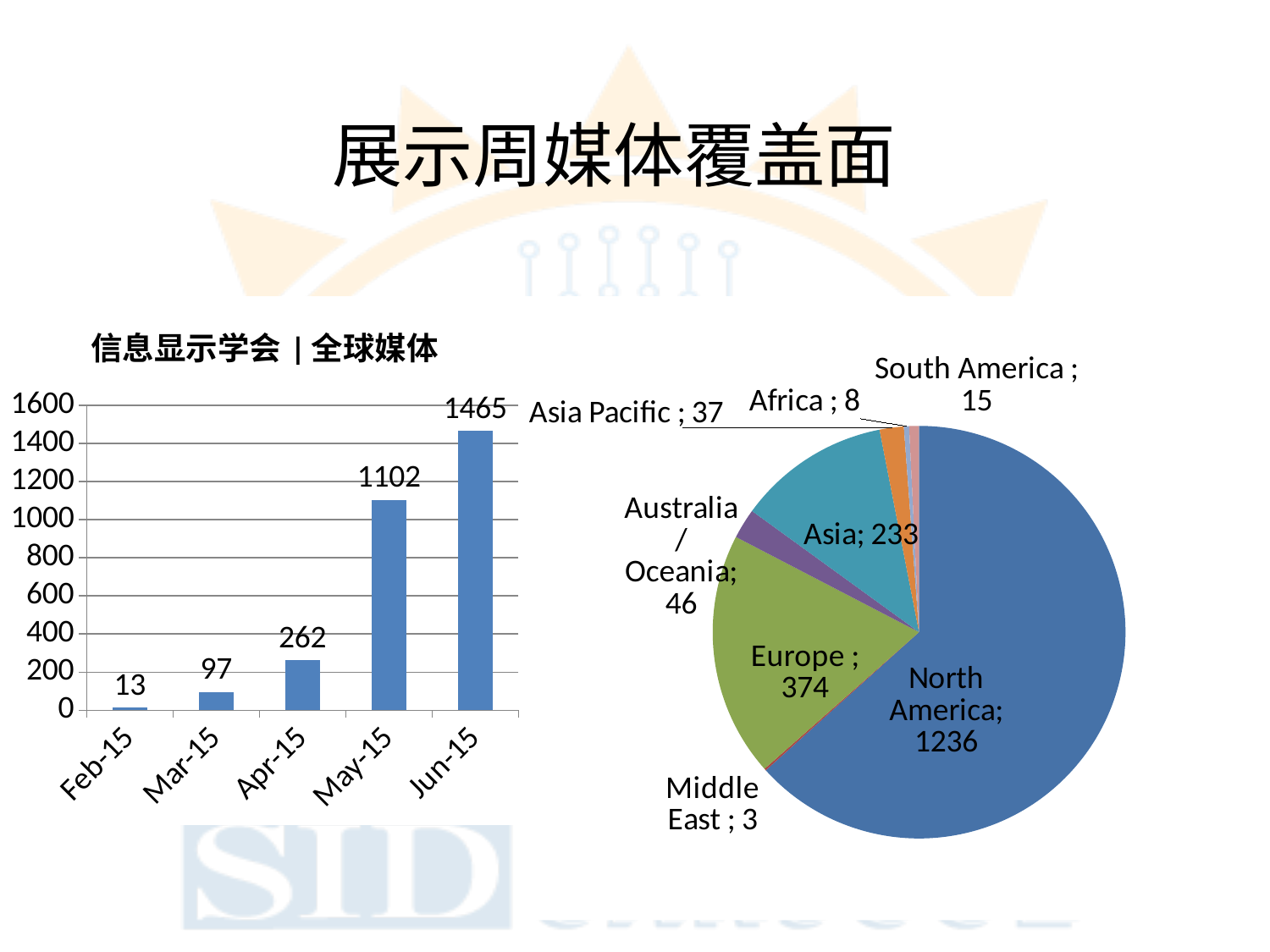
In the bar chart on the left, do the values rise or fall from Feb-15 to Jun-15? rise In the bar chart on the left, what is the value for Feb-15? 13 In the pie chart on the right, how many regions are shown? 8 In the bar chart on the left, which month has the highest value? Jun-15 In the pie chart on the right, what is the value for Europe? 374 In the bar chart on the left, what is the value for May-15? 1102 In the bar chart on the left, what is the difference between the values for Jun-15 and May-15? 363 In the bar chart on the left, how many months are shown on the x axis? 5 In the pie chart on the right, which region has the largest slice? North America What kind of chart is the chart on the left of the slide? bar chart In the bar chart on the left, which month has the lowest value? Feb-15 In the pie chart on the right, which is larger, Asia or Asia Pacific? Asia